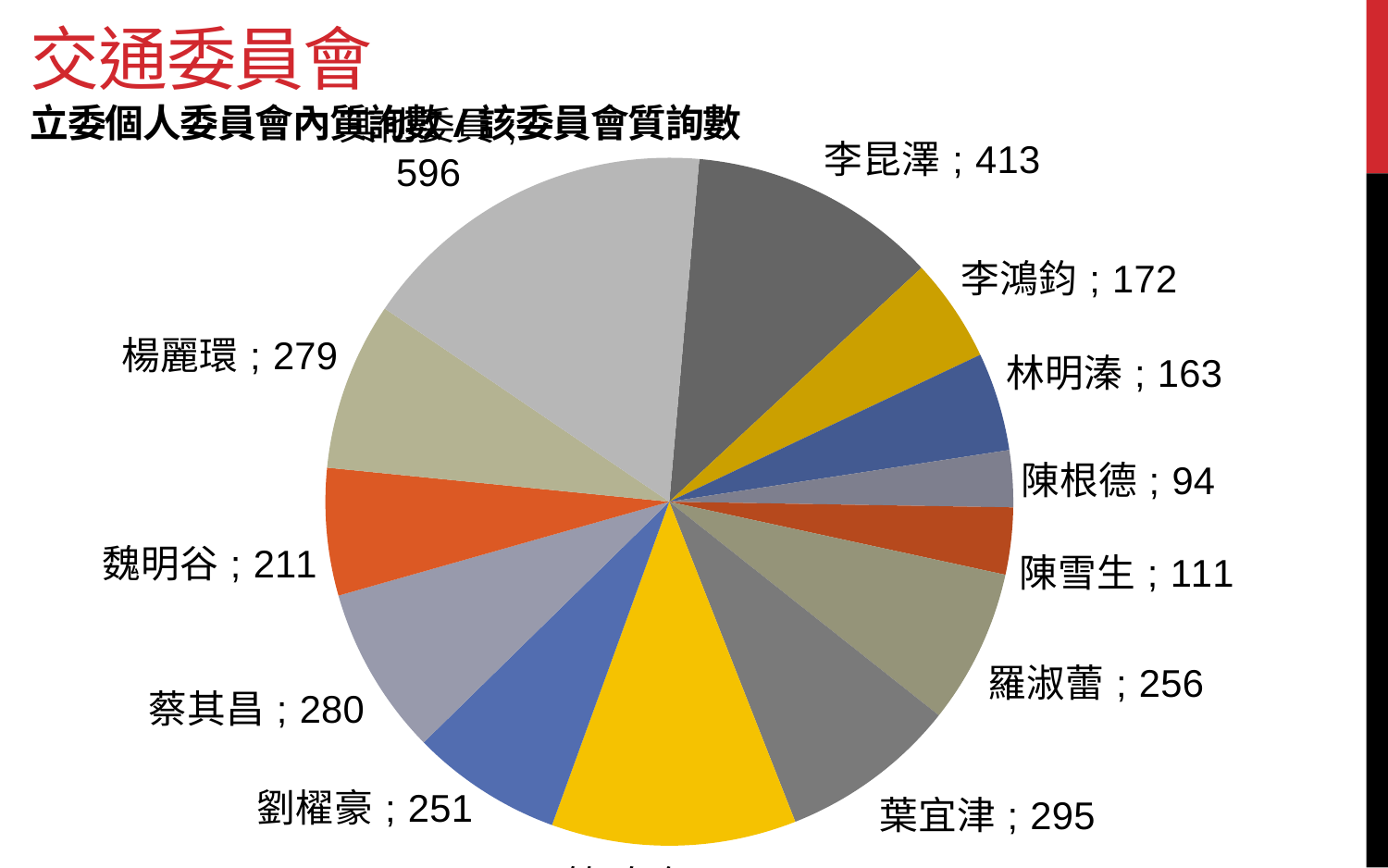
What is the difference between the values for 陳雪生 and 陳根德? 17 Which is larger, the value for 魏明谷 or the value for 劉櫂豪? 劉櫂豪 Which labelled slice has the lowest value? 陳根德 What is the difference between the values for 李昆澤 and 李鴻鈞? 241 Which is larger, the value for 李昆澤 or the value for 葉宜津? 李昆澤 What kind of chart is shown on the slide? pie chart What value is shown for 李昆澤? 413 What value is shown for 陳根德? 94 How many slices does the pie chart have? 13 What value is shown for 葉宜津? 295 What value is shown for 楊麗環? 279 What is the difference between the values for 葉宜津 and 羅淑蕾? 39